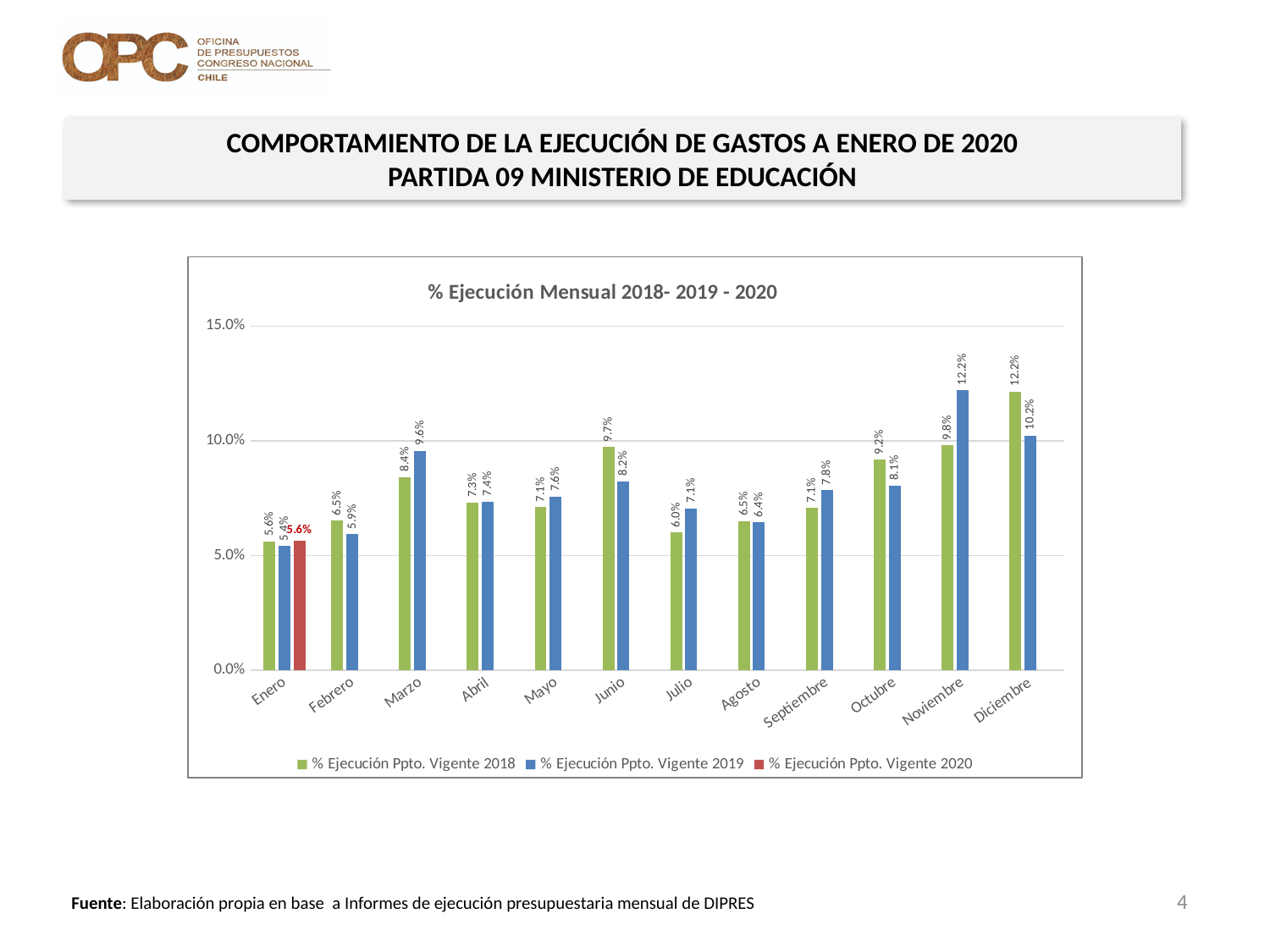
What is the title of the chart? % Ejecución Mensual 2018- 2019 - 2020 In Octubre, which series is larger: % Ejecución Ppto. Vigente 2018 or % Ejecución Ppto. Vigente 2019? % Ejecución Ppto. Vigente 2018 What is the difference between the 2019 and 2018 values in Noviembre? 2.4% How many months are shown on the x axis? 12 Which colour represents % Ejecución Ppto. Vigente 2020? Red Which month has the highest value for % Ejecución Ppto. Vigente 2018? Diciembre What is the value for % Ejecución Ppto. Vigente 2019 in Marzo? 9.6% What is the value for % Ejecución Ppto. Vigente 2018 in Junio? 9.7% Which month has the lowest value for % Ejecución Ppto. Vigente 2019? Enero What is the value for % Ejecución Ppto. Vigente 2020 in Enero? 5.6% How many series does the legend list? 3 What kind of chart is shown on the slide? Bar chart